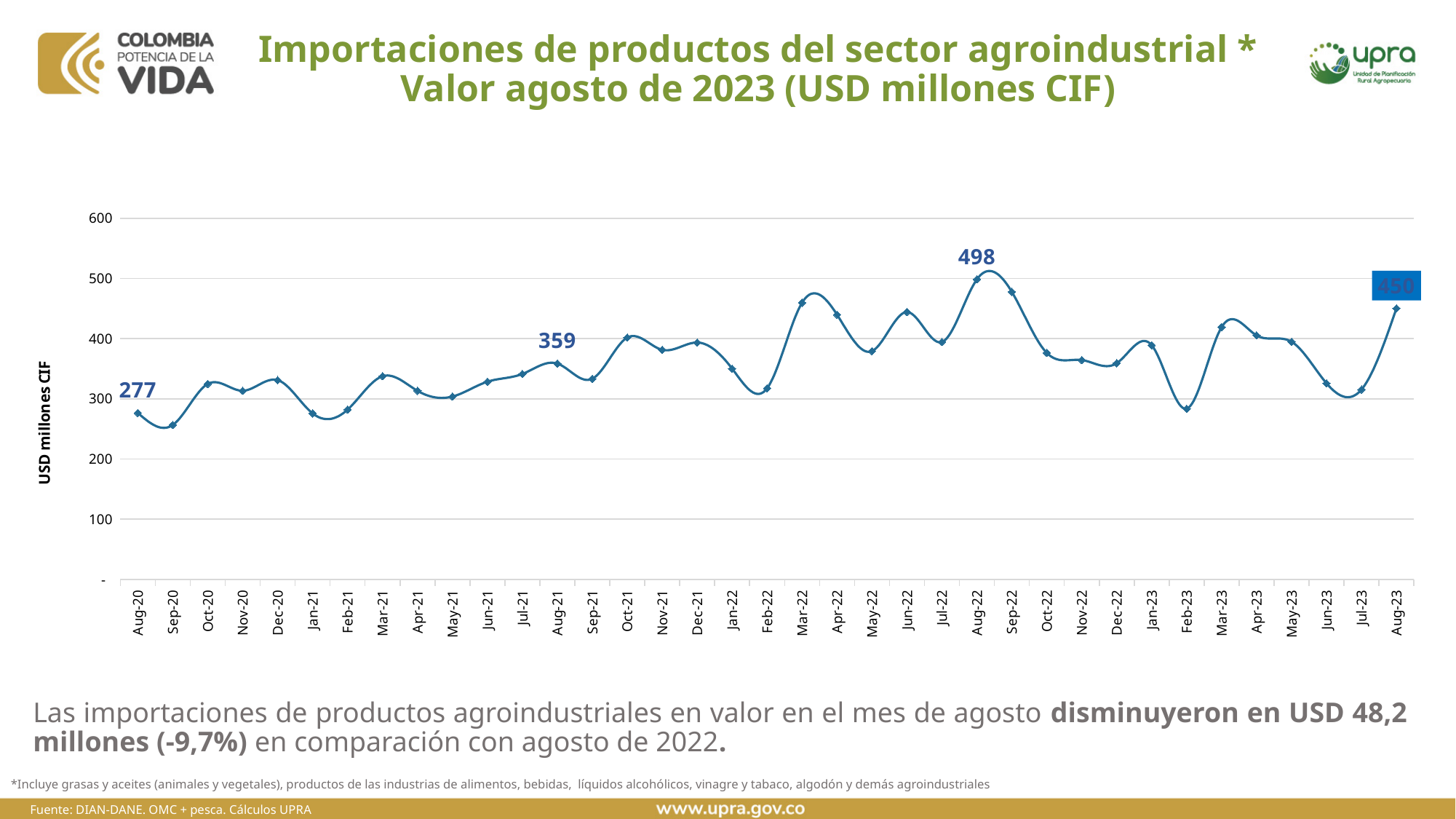
What is the difference between the values for Aug-22 and Aug-23? 48 Is the value for Feb-23 greater or less than 300? less Which month has the highest value on the chart? Aug-22 Is the value for Mar-22 greater or less than 400? greater What is the value for Aug-20? 277 What is the difference between the values for Aug-21 and Aug-20? 82 What is the value for Aug-21? 359 What is the value for Aug-23? 450 What kind of chart is shown on the slide? line chart Which month has the lowest value on the chart? Sep-20 What is the value for Aug-22? 498 Which is larger, the value for Aug-21 or the value for Aug-23? Aug-23